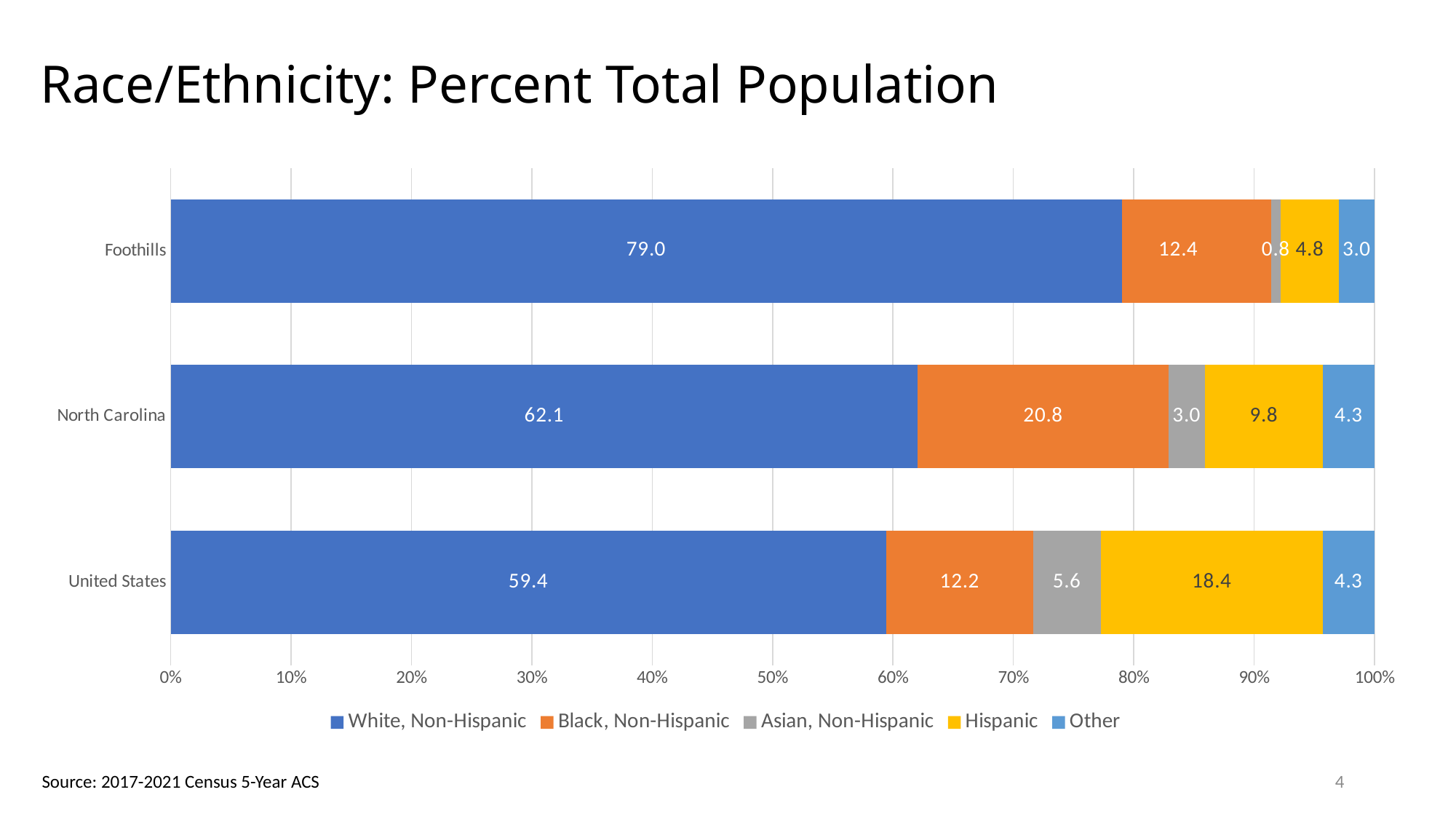
Which region has the highest White, Non-Hispanic value? Foothills How many regions are shown on the chart? 3 Which is larger, the Hispanic value for North Carolina or for the United States? United States What is the title of the slide? Race/Ethnicity: Percent Total Population What kind of chart is shown on the slide? Stacked bar chart Which region has the lowest Asian, Non-Hispanic value? Foothills What is the White, Non-Hispanic value for Foothills? 79.0 What is the difference between the Black, Non-Hispanic values for North Carolina and Foothills? 8.4 What is the Hispanic value for the United States? 18.4 What is the Asian, Non-Hispanic value for North Carolina? 3.0 How many series does the legend list? 5 What is the source cited for the chart? 2017-2021 Census 5-Year ACS